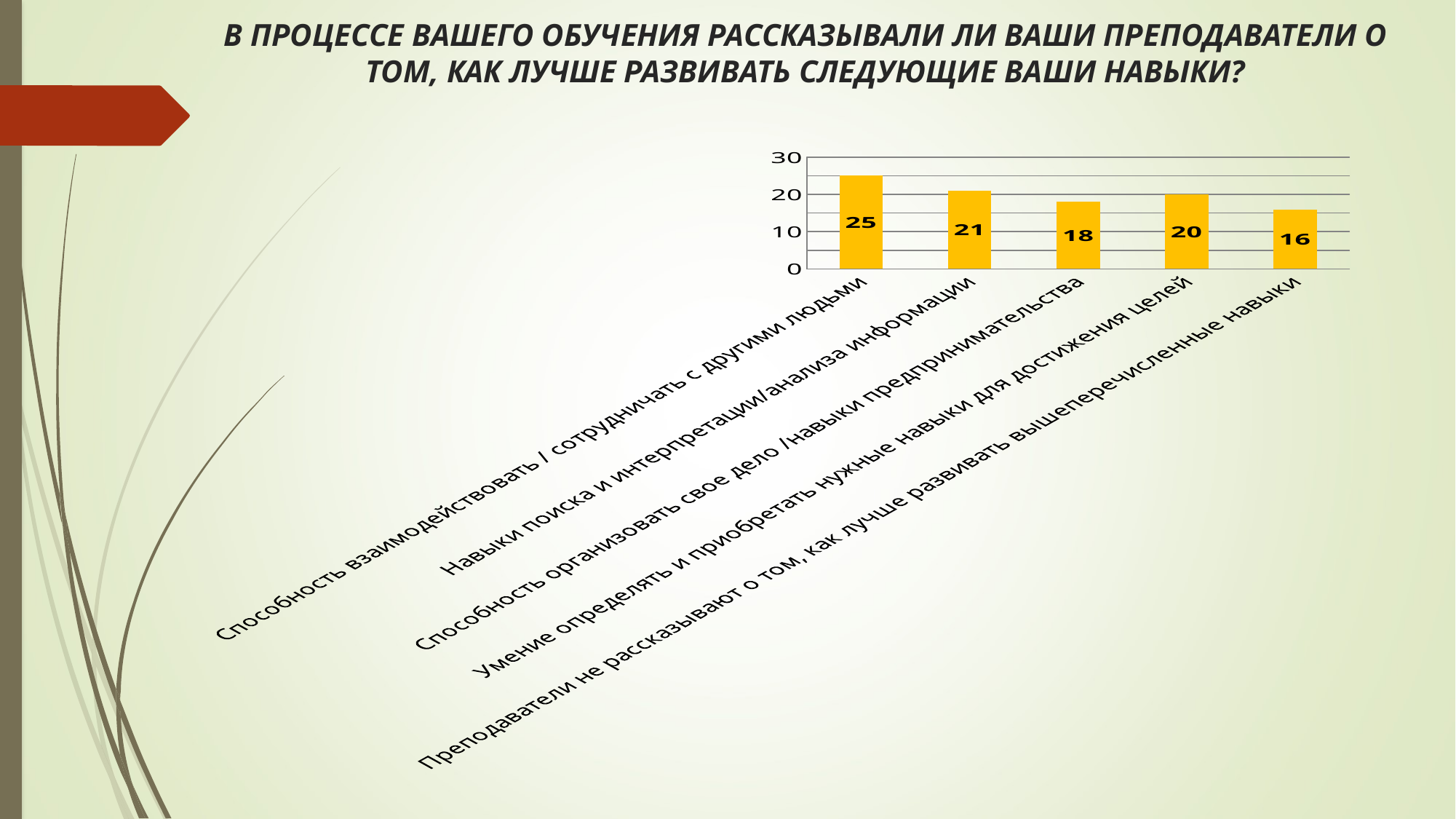
What is the value for "Преподаватели не рассказывают о том, как лучше развивать вышеперечисленные навыки"? 16 Which category has the lowest value? Преподаватели не рассказывают о том, как лучше развивать вышеперечисленные навыки Which category has the highest value? Способность взаимодействовать / сотрудничать с другими людьми What is the value for "Способность взаимодействовать / сотрудничать с другими людьми"? 25 How many categories are shown in the chart? 5 What is the difference between the values for "Способность взаимодействовать / сотрудничать с другими людьми" and "Преподаватели не рассказывают о том, как лучше развивать вышеперечисленные навыки"? 9 Which is larger: the value for "Навыки поиска и интерпретации/анализа информации" or the value for "Умение определять и приобретать нужные навыки для достижения целей"? Навыки поиска и интерпретации/анализа информации What is the value for "Умение определять и приобретать нужные навыки для достижения целей"? 20 What is the value for "Навыки поиска и интерпретации/анализа информации"? 21 What is the value for "Способность организовать свое дело /навыки предпринимательства"? 18 Is the value for "Способность организовать свое дело /навыки предпринимательства" greater or less than 20? less What kind of chart is shown on the slide? bar chart